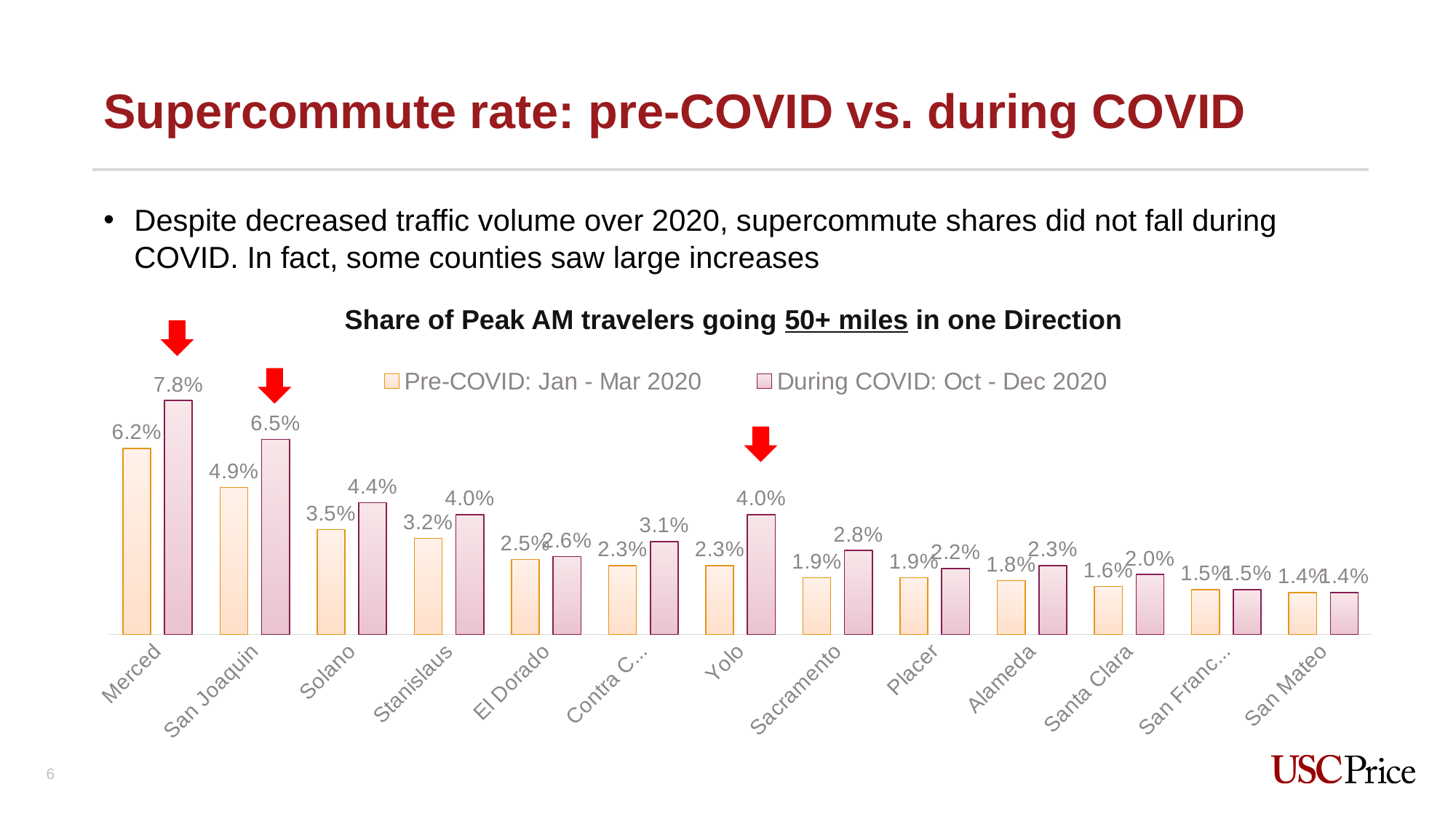
What is the difference between the During COVID and Pre-COVID values for Yolo? 1.7% What is the difference between the During COVID and Pre-COVID values for San Joaquin? 1.6% Which county has the lowest Pre-COVID: Jan - Mar 2020 value? San Mateo What is the Pre-COVID: Jan - Mar 2020 value for Merced? 6.2% What kind of chart is shown on the slide? Bar chart What is the During COVID: Oct - Dec 2020 value for Solano? 4.4% How many counties are shown on the x axis? 13 What is the During COVID: Oct - Dec 2020 value for Yolo? 4.0% Which county has the highest During COVID: Oct - Dec 2020 value? Merced What is the title of the chart? Share of Peak AM travelers going 50+ miles in one Direction Which is larger: the Pre-COVID value for Stanislaus or the Pre-COVID value for Solano? Solano How many series does the legend list? 2